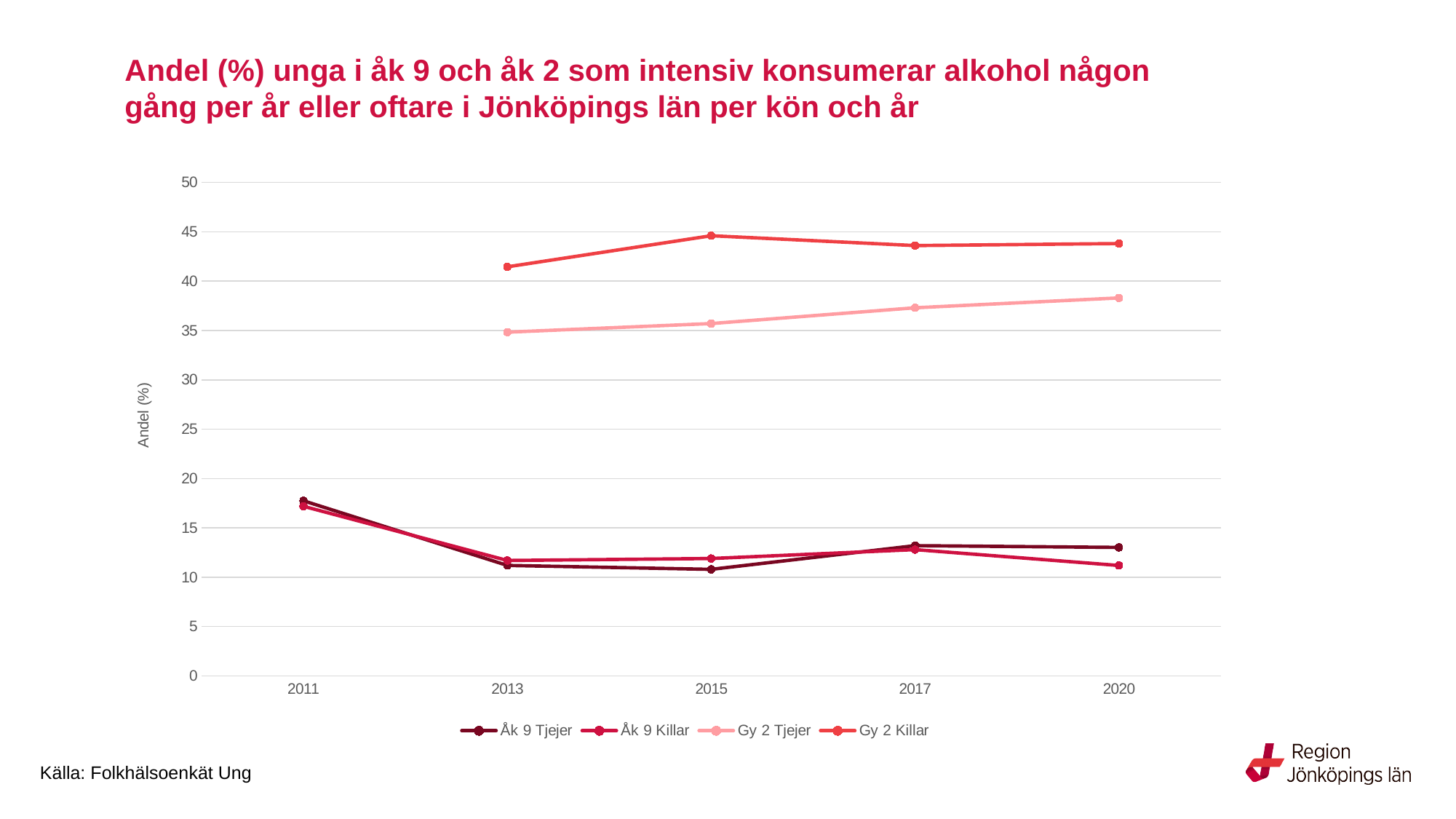
Is the value for Gy 2 Tjejer in 2020 greater or less than 40? less Is the value for Åk 9 Tjejer in 2015 greater or less than 15? less Is the value for Åk 9 Killar in 2011 greater or less than 15? greater Which series has the lowest value in 2020? Åk 9 Killar What is the label on the y axis? Andel (%) Does the Gy 2 Tjejer line rise or fall from 2013 to 2020? rise What kind of chart is shown on the slide? line chart How many series does the legend list? 4 In 2017, which is larger: Gy 2 Killar or Gy 2 Tjejer? Gy 2 Killar How many years are shown on the x axis? 5 Which series has the highest value in 2020? Gy 2 Killar